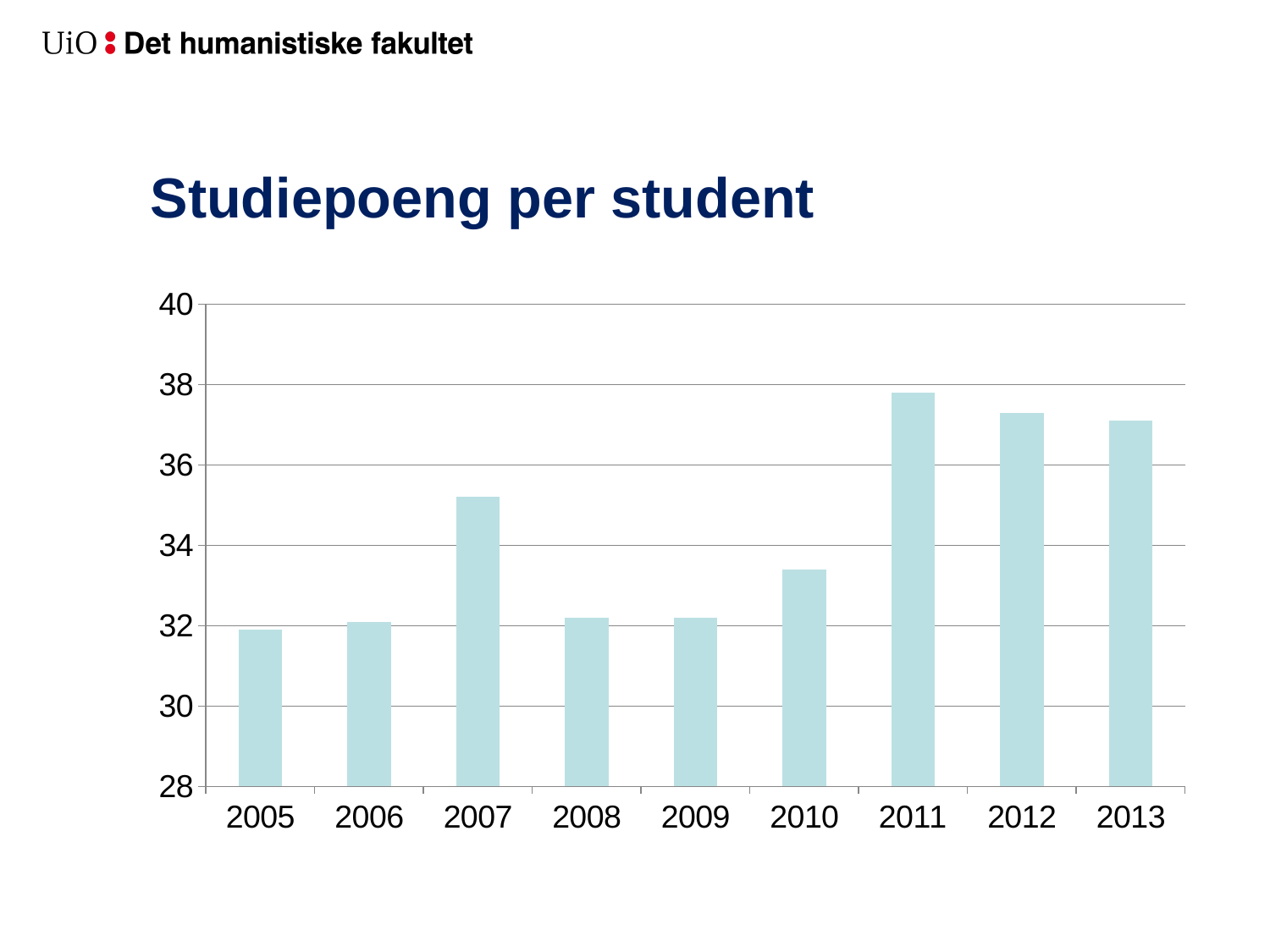
Is the value for 2007 greater or less than 34? greater How many years are shown on the x axis of the chart? 9 Which is larger, the value for 2007 or the value for 2010? 2007 Is the value for 2013 greater or less than 36? greater What kind of chart is shown on the slide? Bar chart Is the value for 2011 greater or less than 36? greater Do the values generally rise or fall from 2005 to 2013? Rise What is the title of the chart? Studiepoeng per student Which is larger, the value for 2012 or the value for 2009? 2012 Which year has the highest value in the chart? 2011